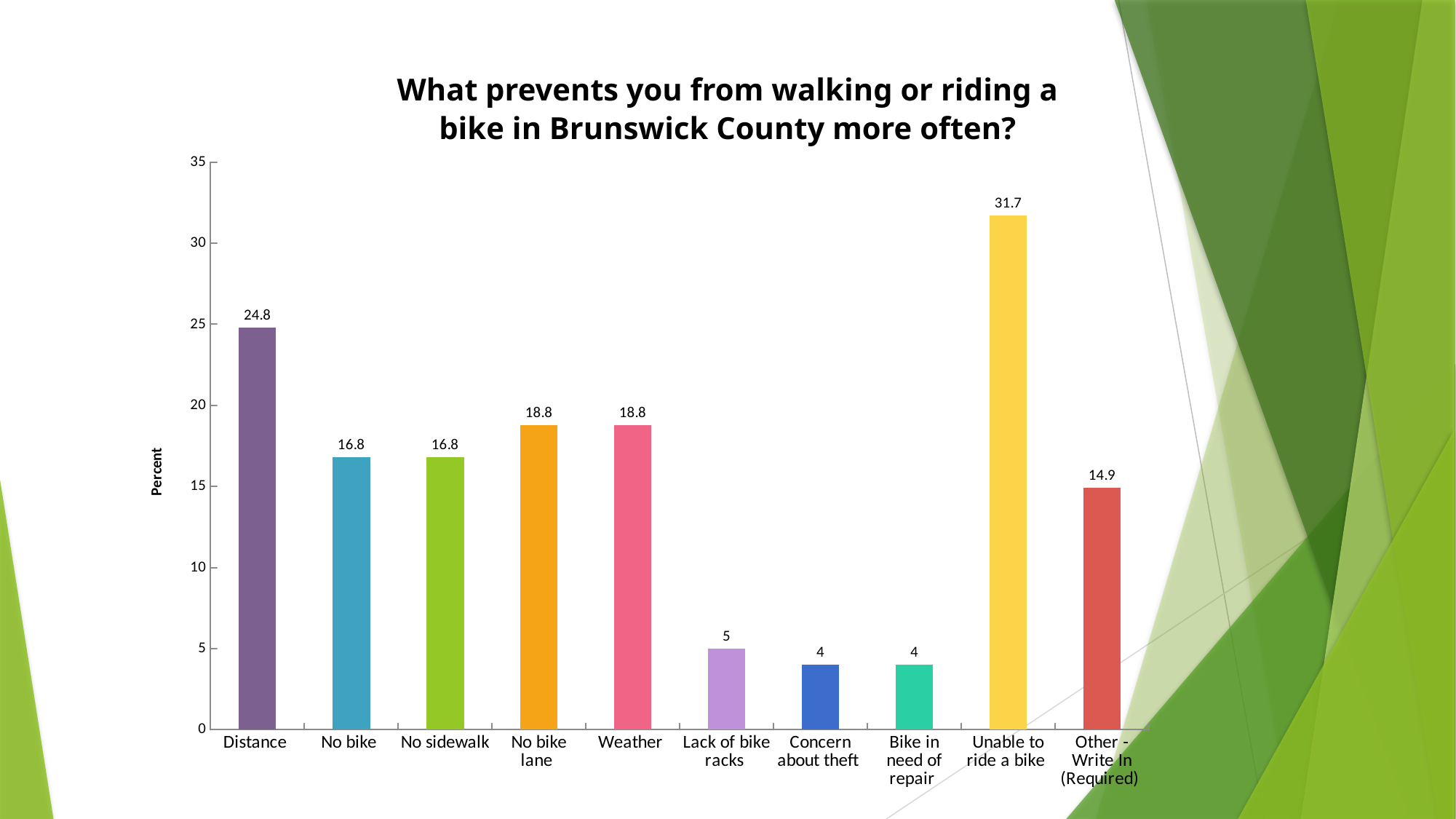
What is the value for Lack of bike racks? 5 What is the difference between the values for Unable to ride a bike and Distance? 6.9 What kind of chart is shown on the slide? bar chart What is the value for Unable to ride a bike? 31.7 What is the value for Other - Write In (Required)? 14.9 How many categories are shown on the x axis? 10 What is the value for Distance? 24.8 What is the difference between the values for No bike lane and No bike? 2 Is the value for Distance greater or less than 20? greater Which category has the highest value? Unable to ride a bike What is the label of the vertical axis? Percent Which is larger, the value for Weather or the value for Other - Write In (Required)? Weather